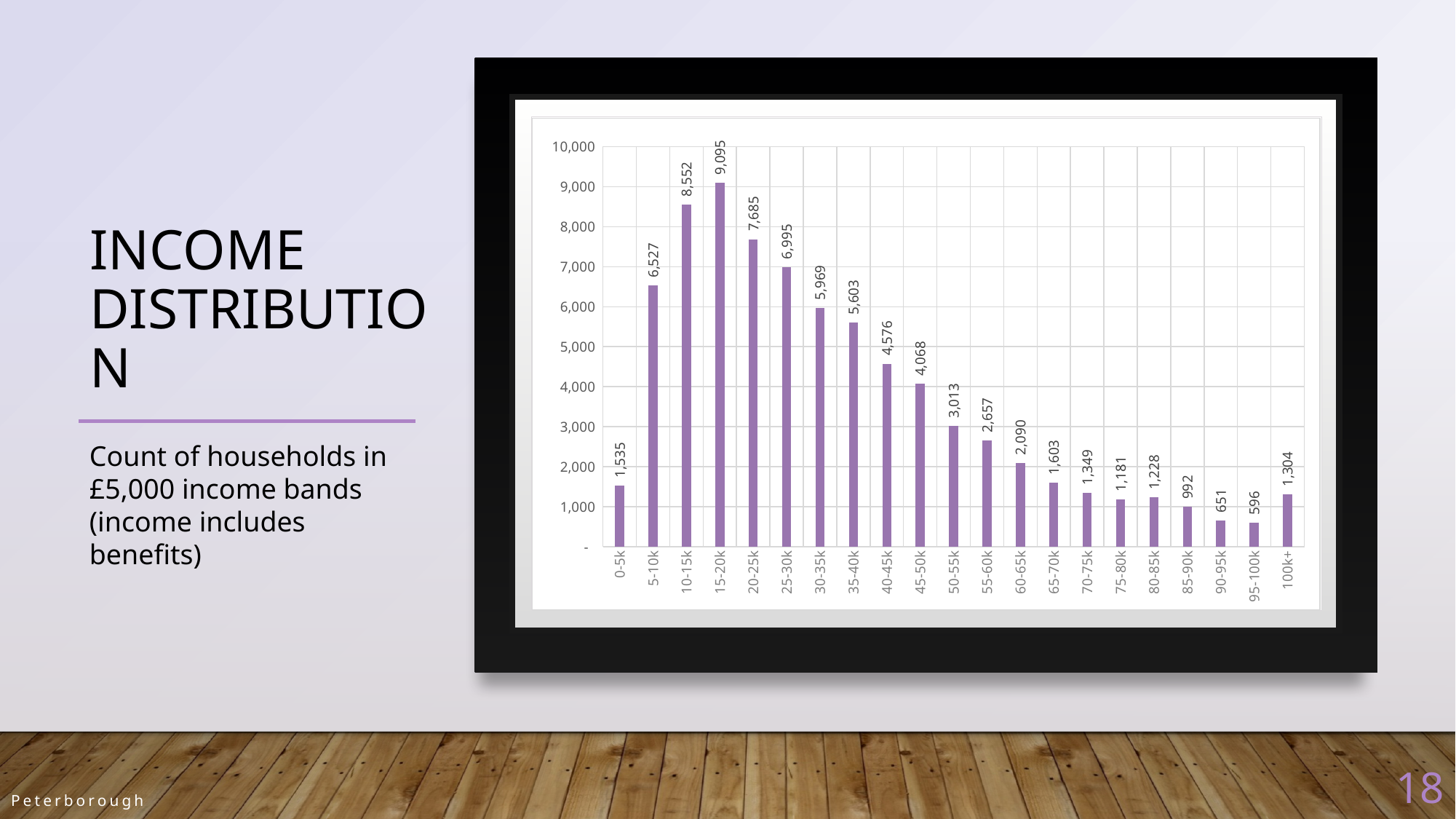
From the 15-20k band to the 95-100k band, do the household counts rise or fall? Fall How many income bands are shown on the chart? 21 What is the count of households in the 15-20k income band? 9,095 What is the count of households in the 45-50k income band? 4,068 Which income band has the lowest count of households? 95-100k What is the count of households in the 100k+ income band? 1,304 Is the value for the 30-35k band greater or less than 5,000? greater What is the difference between the household counts for the 10-15k and 5-10k bands? 2,025 What kind of chart is shown on the slide? Bar chart Which income band has the highest count of households? 15-20k What is the count of households in the 0-5k income band? 1,535 Which band has more households, 75-80k or 80-85k? 80-85k